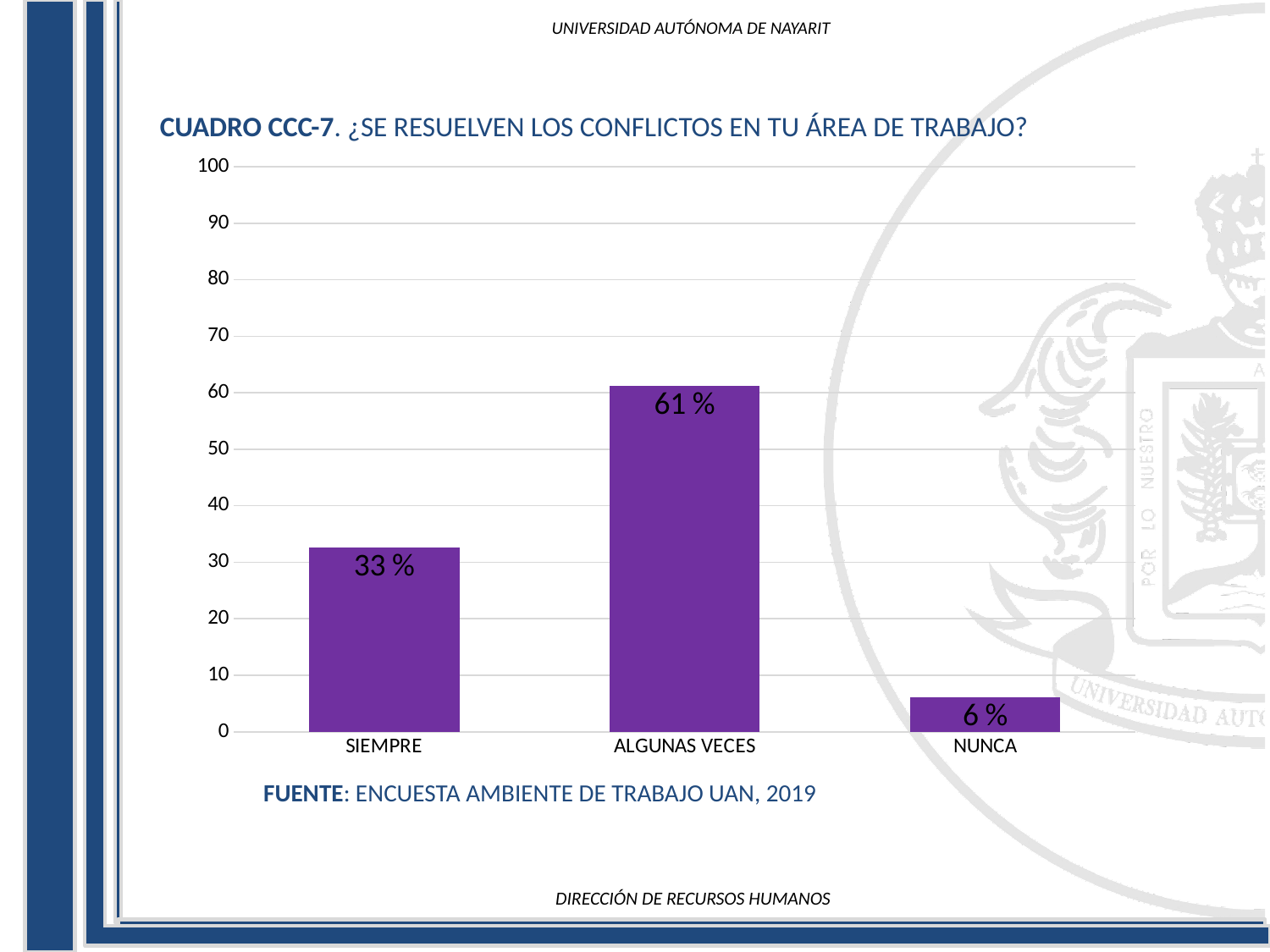
What is the difference between the values for ALGUNAS VECES and SIEMPRE? 28 % What is the value for ALGUNAS VECES? 61 % Is the value for ALGUNAS VECES greater or less than 50? greater How many categories are shown on the x axis? 3 What kind of chart is shown on the slide? bar chart What is the value for SIEMPRE? 33 % Which is larger, the value for SIEMPRE or the value for NUNCA? SIEMPRE What is the difference between the values for SIEMPRE and NUNCA? 27 % What is the value for NUNCA? 6 % What source is cited below the chart? ENCUESTA AMBIENTE DE TRABAJO UAN, 2019 Which category has the highest value? ALGUNAS VECES Which category has the lowest value? NUNCA